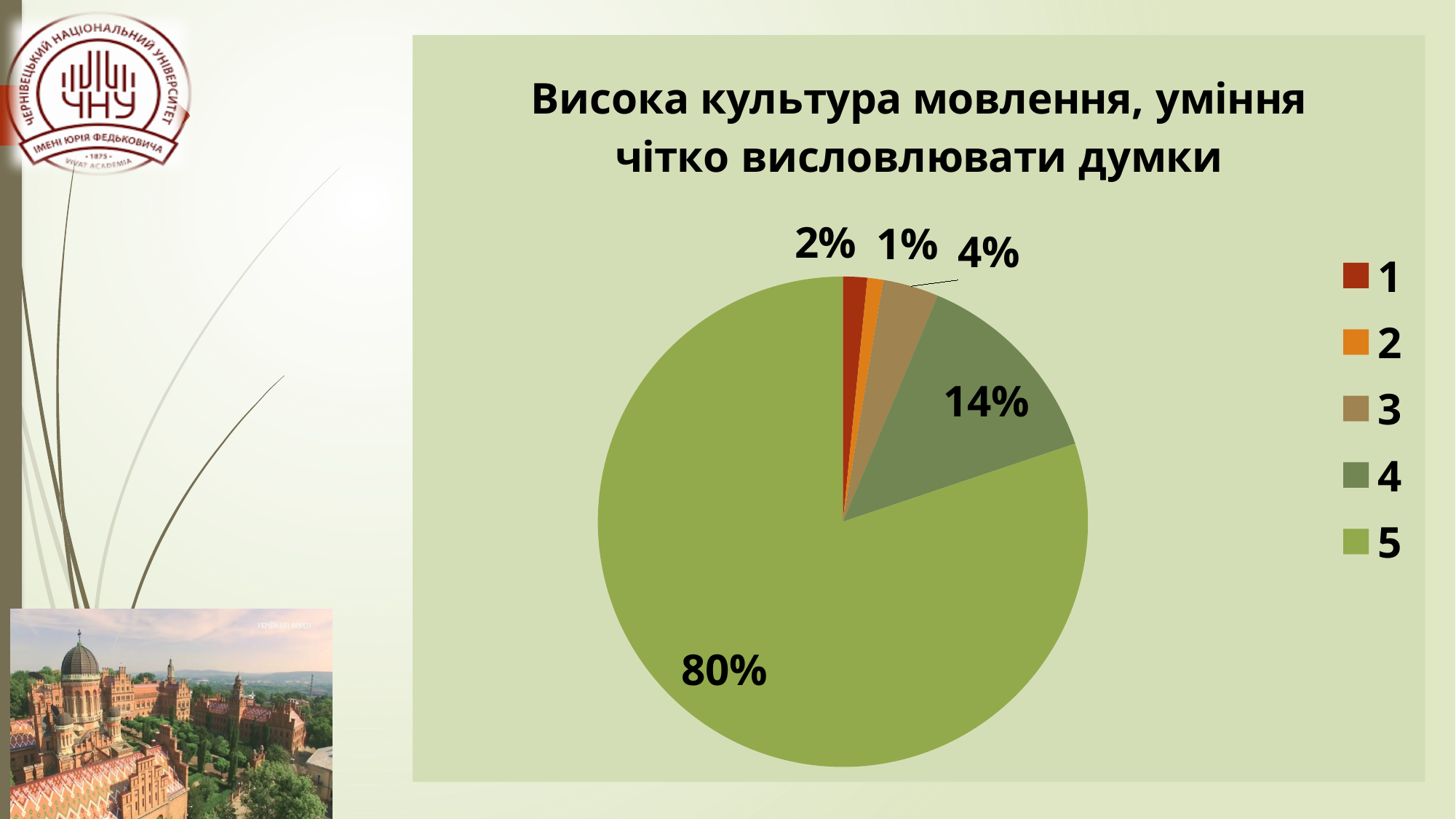
What is the difference between the shares of category 5 and category 4? 66% What share of the pie does category 3 have? 4% Which category has the largest slice of the pie? 5 What is the title of the chart? Висока культура мовлення, уміння чітко висловлювати думки What share of the pie does category 5 have? 80% What share of the pie does category 1 have? 2% How many categories does the legend list? 5 What kind of chart is shown on the slide? pie chart What share of the pie does category 4 have? 14% Which is larger, the share of category 3 or the share of category 1? category 3 What share of the pie does category 2 have? 1% Which category has the smallest slice of the pie? 2